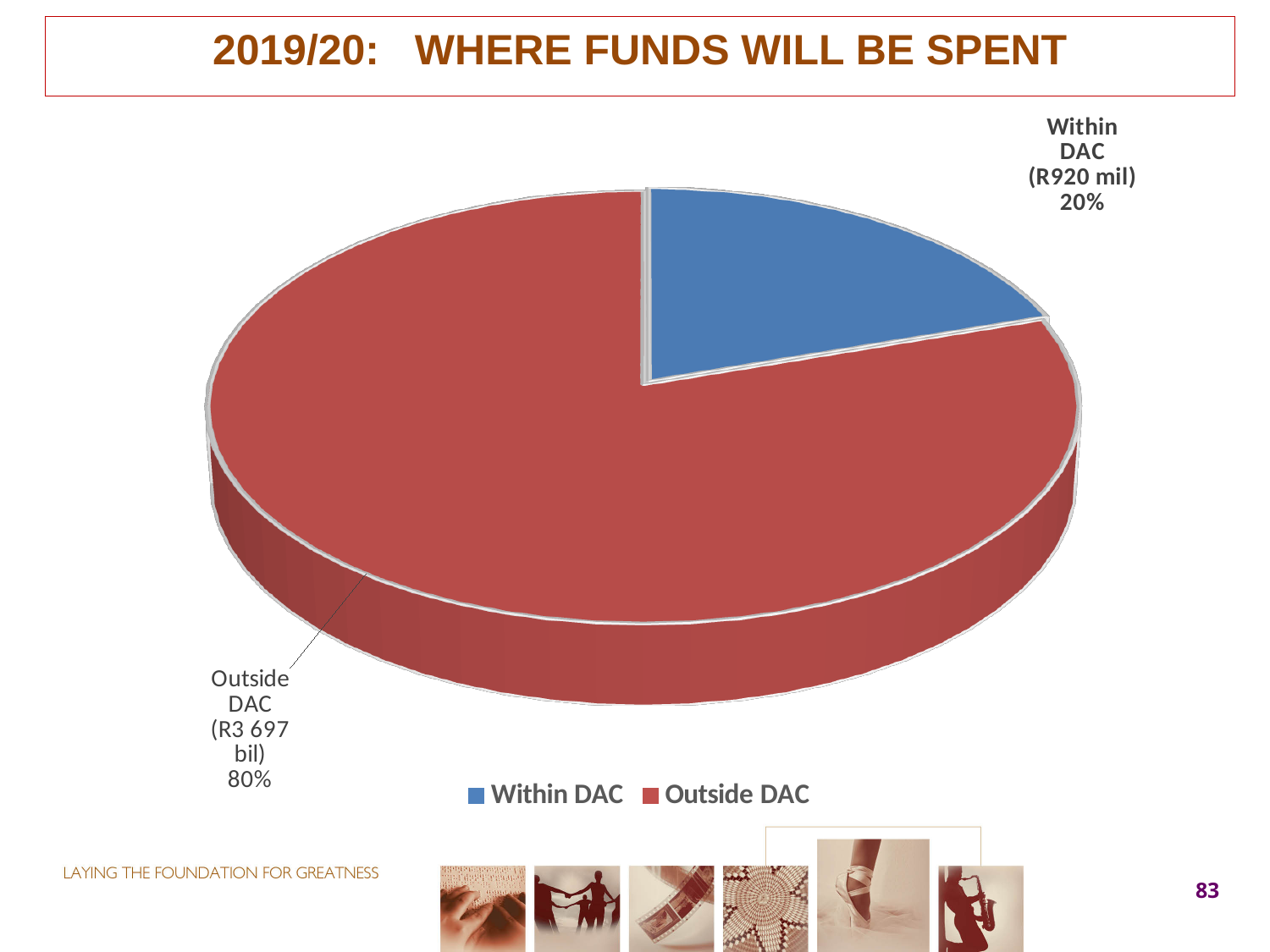
How many slices does the pie chart have? 2 What amount is shown for the Outside DAC slice? R3 697 bil Which slice is the largest? Outside DAC What colour is the Within DAC slice? Blue Which is larger, the share for Within DAC or Outside DAC? Outside DAC What percentage of funds will be spent Outside DAC? 80% What percentage of funds will be spent Within DAC? 20% What amount is shown for the Within DAC slice? R920 mil What kind of chart is shown on the slide? Pie chart How many entries does the legend list? 2 What is the difference in percentage points between the Outside DAC and Within DAC shares? 60 Which slice is the smallest? Within DAC